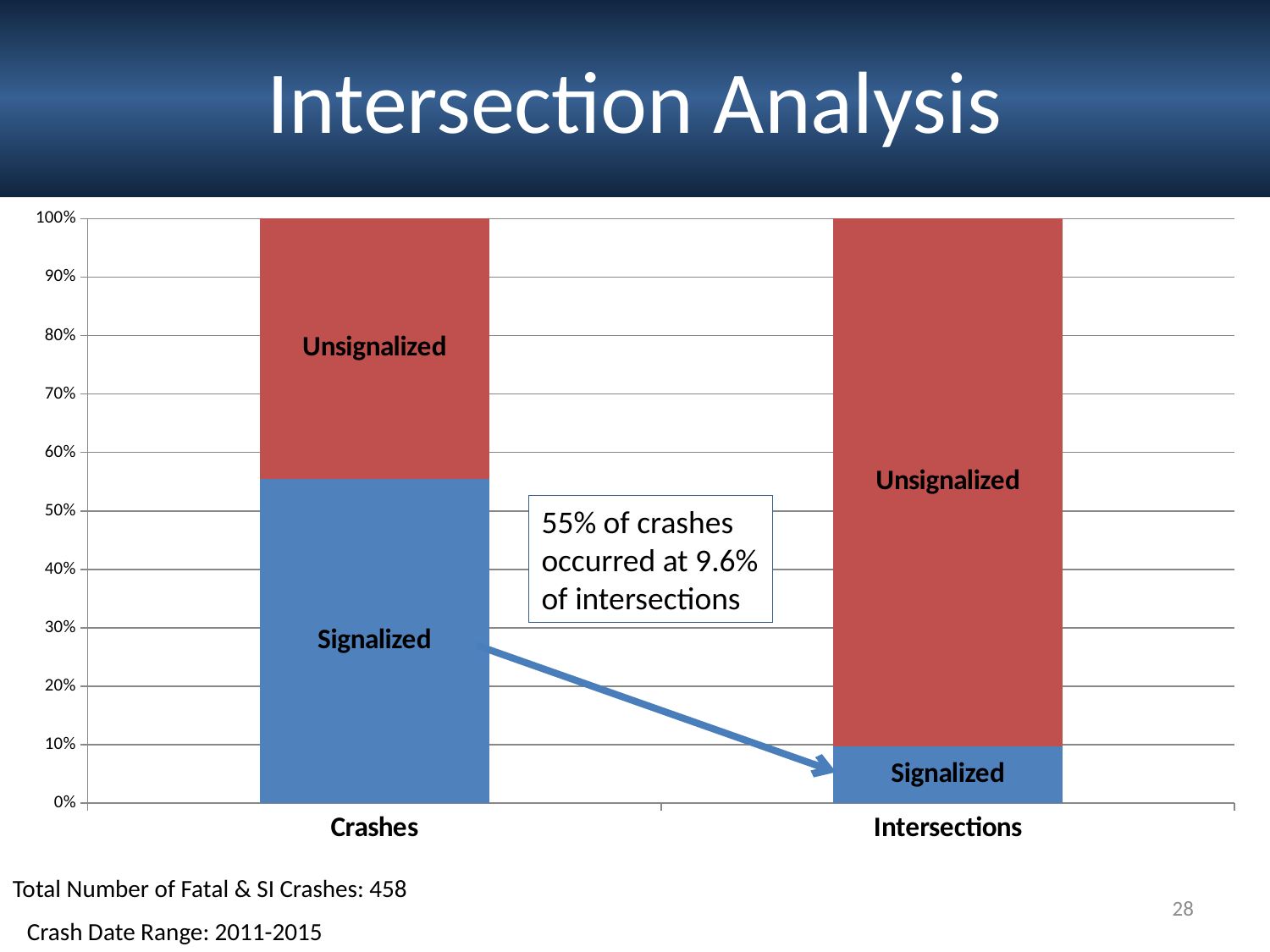
What colour represents the Signalized segment in the chart? Blue In the Crashes bar, which segment is larger, Signalized or Unsignalized? Signalized What is the total height of each stacked bar? 100% How many categories are shown on the x axis of the chart? 2 How many segments does each stacked bar contain? 2 Is the Signalized share of the Intersections bar greater or less than 20%? less In the Intersections bar, which segment is larger, Signalized or Unsignalized? Unsignalized What percentage of crashes occurred at signalized intersections according to the chart? 55% What percentage of intersections are signalized according to the chart? 9.6% What kind of chart is shown on the slide? Stacked bar chart Which bar has the larger Signalized share, Crashes or Intersections? Crashes Is the Signalized share of the Crashes bar greater or less than 50%? greater